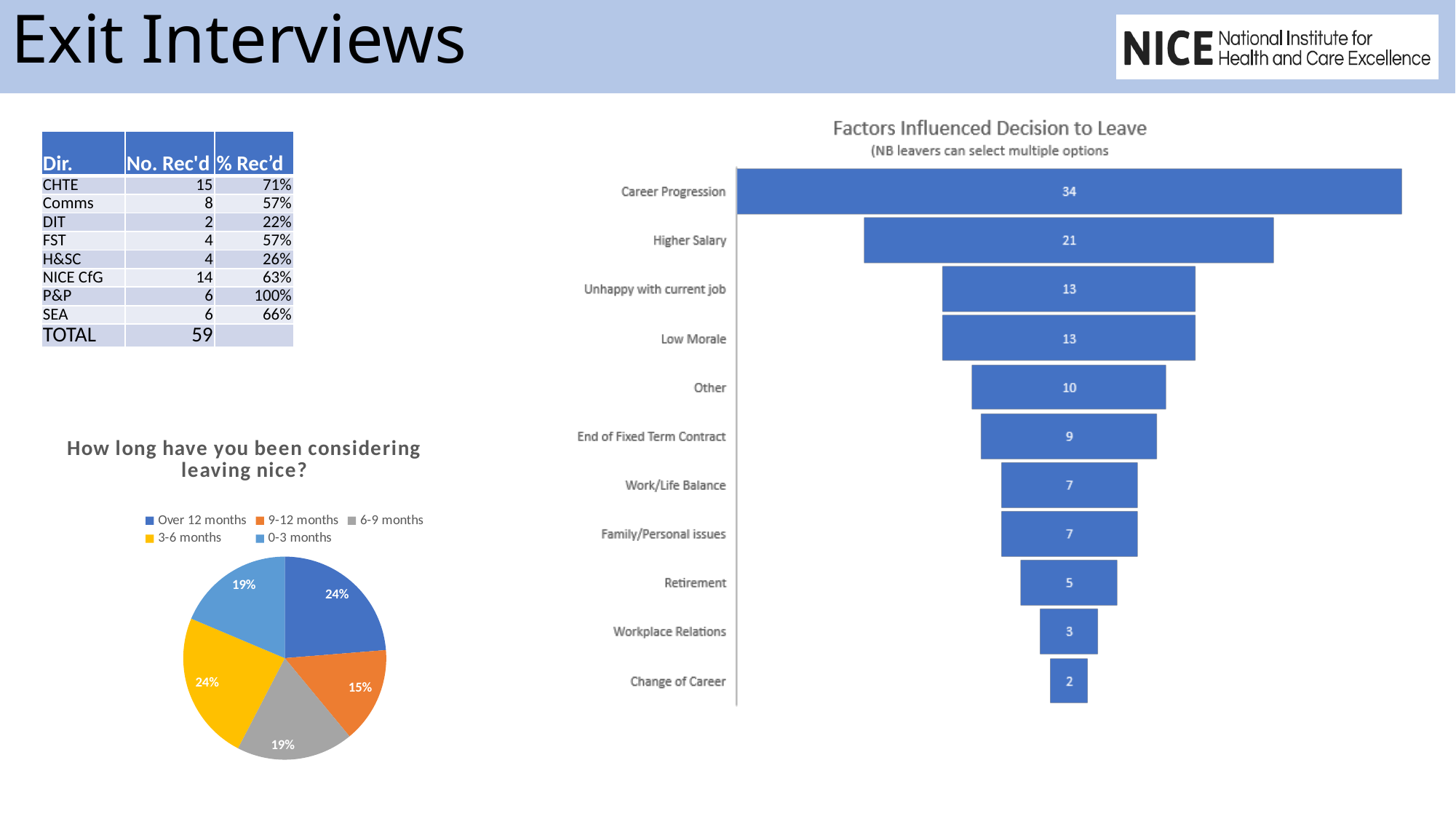
How many entries does the legend of the pie chart 'How long have you been considering leaving nice?' list? 5 In the pie chart 'How long have you been considering leaving nice?', what share is 0-3 months? 19% In the 'Factors Influenced Decision to Leave' chart, which is larger: Other or Retirement? Other In the 'Factors Influenced Decision to Leave' chart, which factor has the highest value? Career Progression In the pie chart 'How long have you been considering leaving nice?', what share is 9-12 months? 15% In the 'Factors Influenced Decision to Leave' chart, what is the difference between Career Progression and Higher Salary? 13 What kind of chart is 'Factors Influenced Decision to Leave'? Bar chart In the 'Factors Influenced Decision to Leave' chart, what is the value for Higher Salary? 21 In the 'Factors Influenced Decision to Leave' chart, which factor has the lowest value? Change of Career In the 'Factors Influenced Decision to Leave' chart, how many factors are listed? 11 In the pie chart 'How long have you been considering leaving nice?', which colour represents 3-6 months? Yellow In the 'Factors Influenced Decision to Leave' chart, what is the value for Career Progression? 34